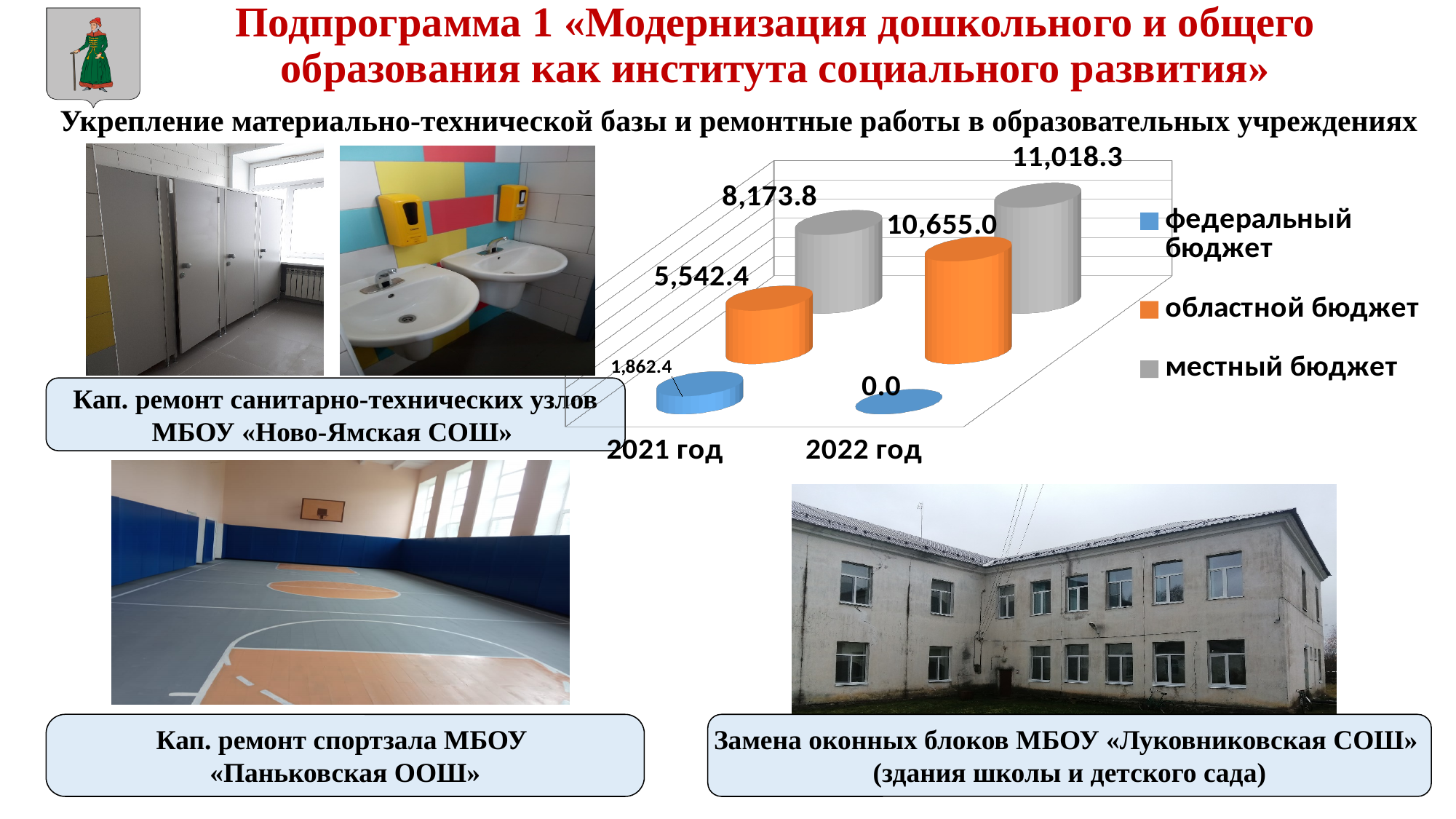
What kind of chart is shown on the slide? bar chart What is the value of местный бюджет for 2022 год? 11,018.3 What is the difference between областной бюджет in 2022 год and in 2021 год? 5,112.6 Which series has the lowest value in 2022 год? федеральный бюджет Which series has the highest value in 2021 год? местный бюджет Which colour represents областной бюджет in the legend? orange What is the value of областной бюджет for 2021 год? 5,542.4 How many series does the legend list? 3 What is the value of федеральный бюджет for 2022 год? 0.0 What is the value of федеральный бюджет for 2021 год? 1,862.4 Which is larger: местный бюджет in 2021 год or областной бюджет in 2022 год? областной бюджет in 2022 год How many year categories are shown on the x axis? 2